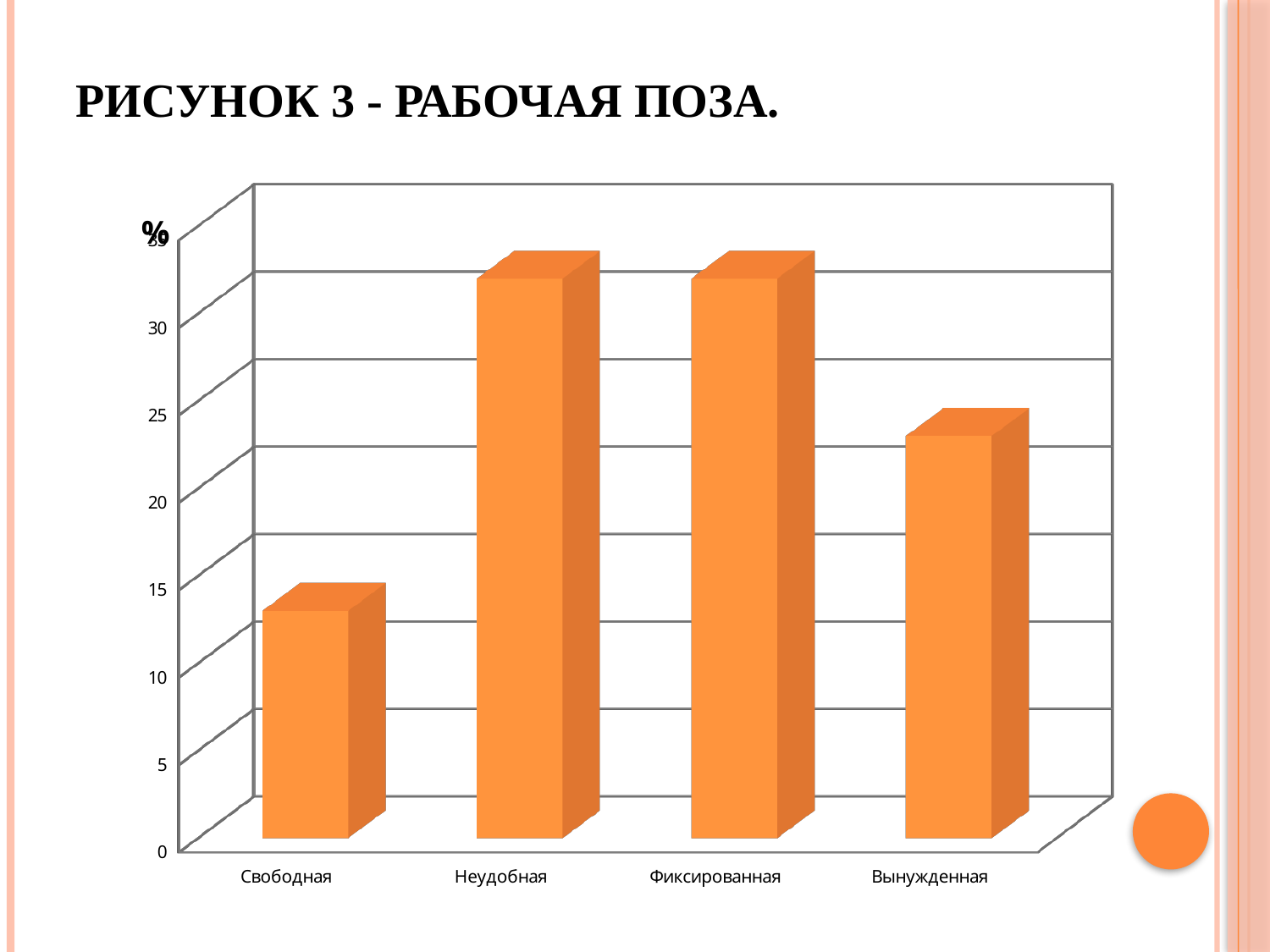
Which is larger, the value for Свободная or the value for Вынужденная? Вынужденная Is the value for Свободная greater or less than 10? greater Is the value for Вынужденная greater or less than 25? less Is the value for Фиксированная greater or less than 30? greater Which category has the lowest bar in the chart? Свободная What kind of chart is shown on the slide? bar chart How many categories are shown on the x axis of the chart? 4 Which is larger, the value for Неудобная or the value for Вынужденная? Неудобная What unit label is shown on the vertical axis of the chart? %